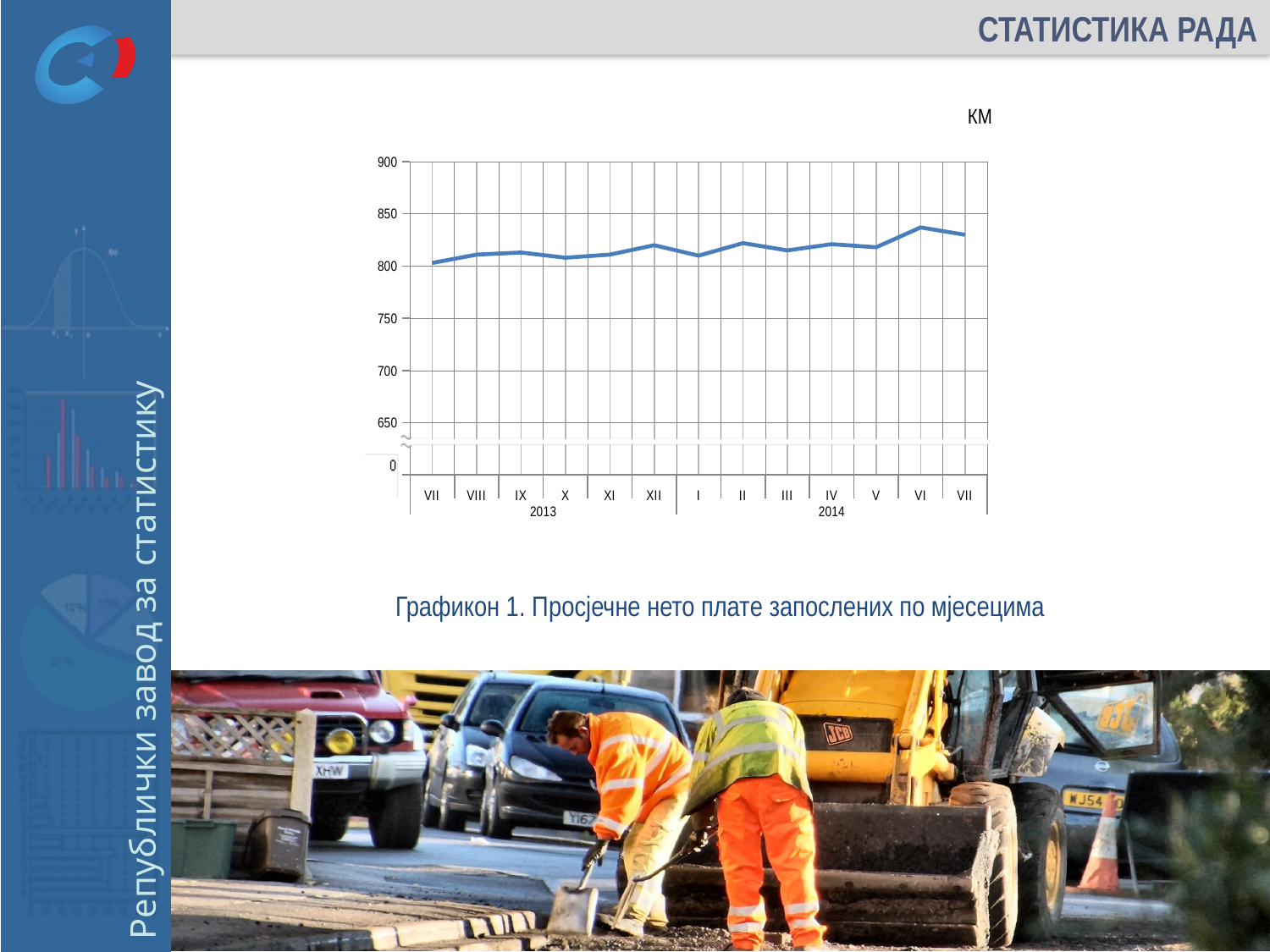
How many monthly data points are plotted on the chart? 13 Do the values generally rise or fall from VII 2013 to VII 2014? rise Is the value for I 2014 greater or less than 750? greater Is the value for XII 2013 greater or less than 850? less Is the value for VI 2014 greater or less than 850? less What unit is shown above the chart's vertical axis? КМ Which month has the lowest average net wage on the chart? VII 2013 What kind of chart is shown on the slide? line chart Which is larger, the value for VI 2014 or the value for VII 2013? VI 2014 Which month has the highest average net wage on the chart? VI 2014 Which is larger, the value for VII 2014 or the value for I 2014? VII 2014